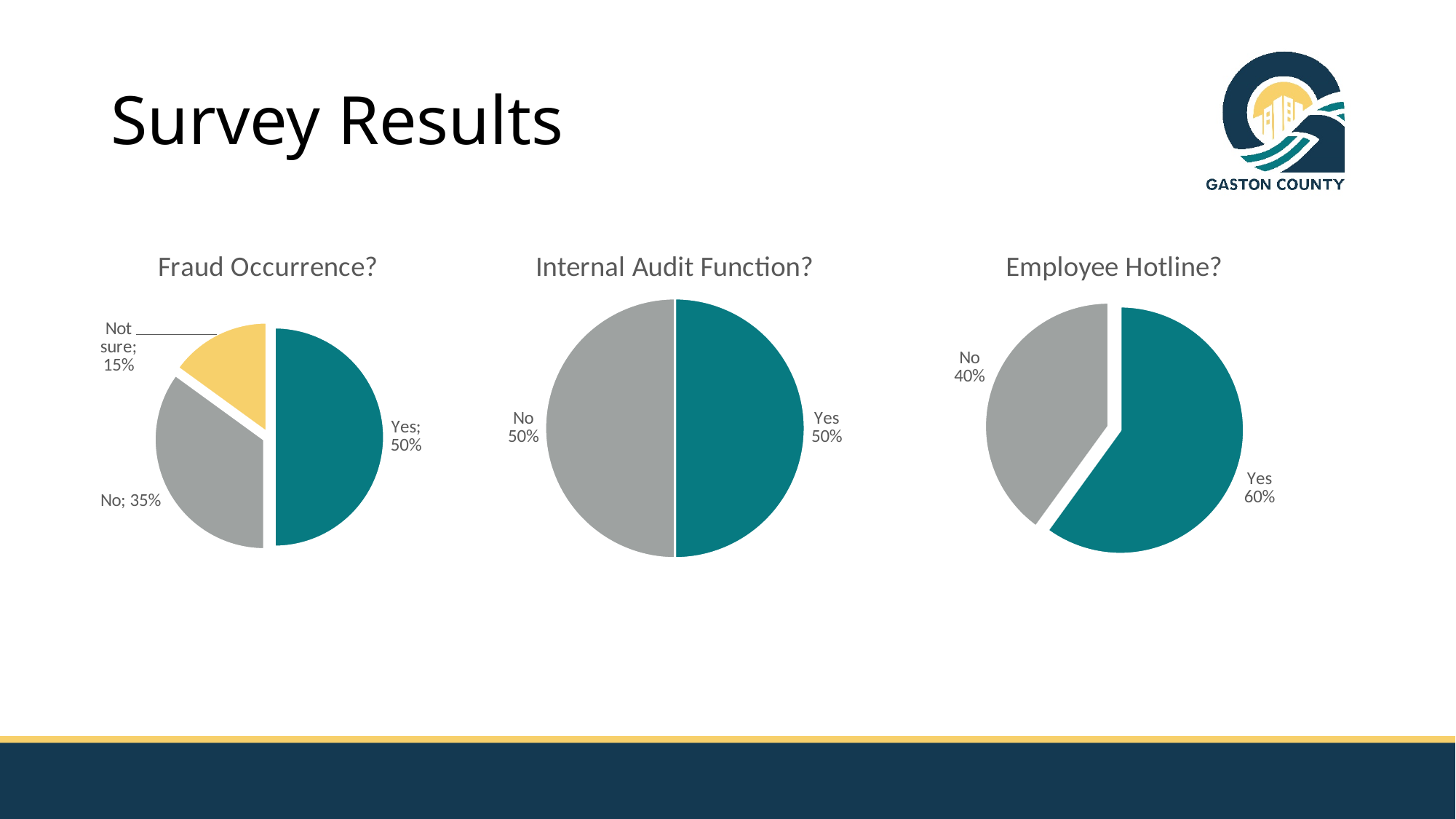
In the "Employee Hotline?" chart, which is larger, "Yes" or "No"? Yes In the "Fraud Occurrence?" chart, which response has the smallest share? Not sure In the "Fraud Occurrence?" chart, which response has the largest share? Yes In the "Employee Hotline?" chart, what share of responses is "No"? 40% In the "Employee Hotline?" chart, what is the difference between the "Yes" and "No" shares? 20% In the "Internal Audit Function?" chart, how many slices does the pie have? 2 In the "Fraud Occurrence?" chart, what share of responses is "No"? 35% What type of chart is the "Employee Hotline?" chart? Pie chart In the "Fraud Occurrence?" chart, how many slices does the pie have? 3 In the "Internal Audit Function?" chart, what share of responses is "Yes"? 50% In the "Fraud Occurrence?" chart, what is the difference between the "Yes" and "No" shares? 15% In the "Fraud Occurrence?" chart, what share of responses is "Not sure"? 15%